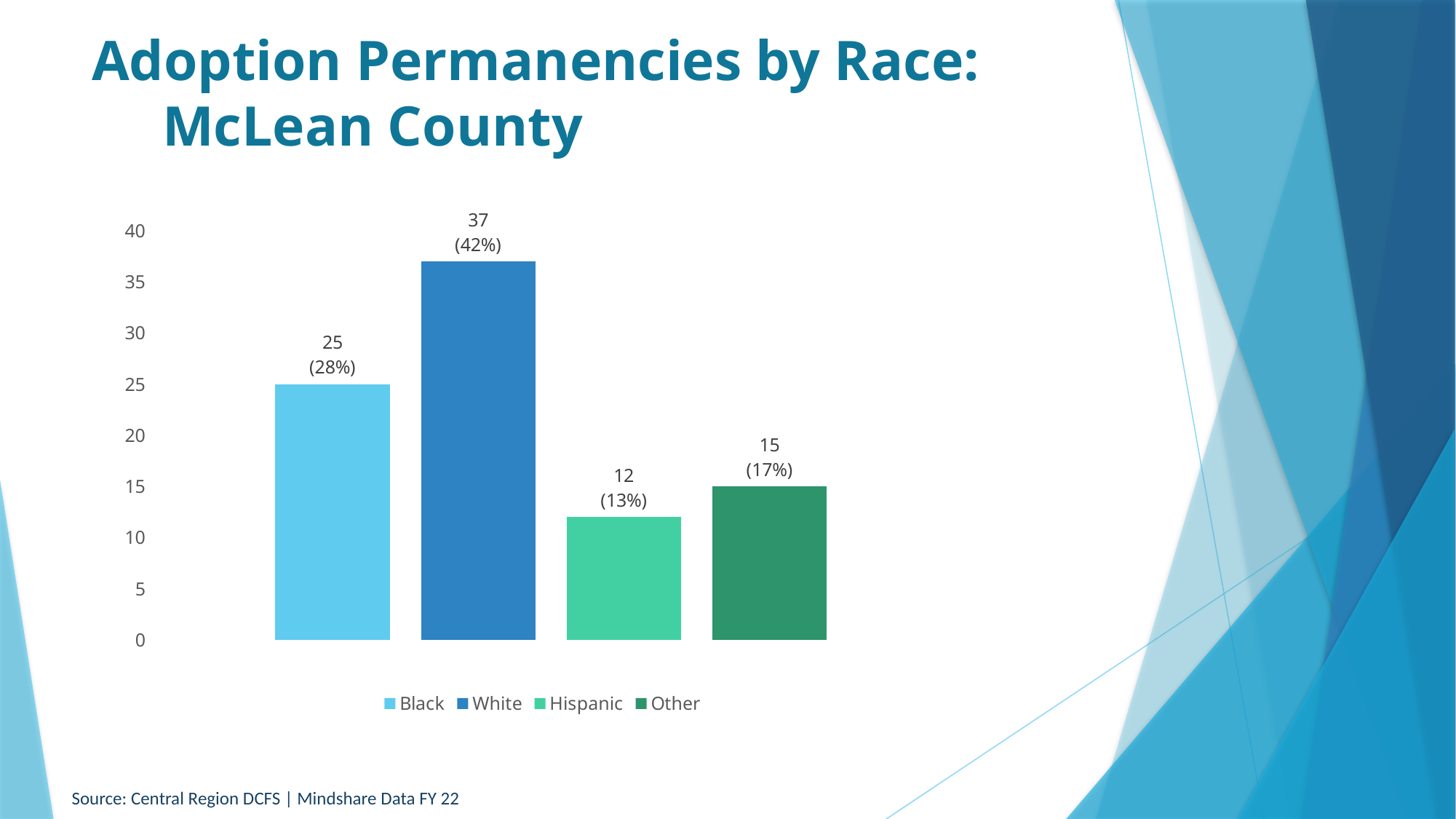
What is the difference between the White and Black values? 12 Which is larger, the value for Other or the value for Hispanic? Other What kind of chart is shown on the slide? Bar chart How many race categories are shown in the chart? 4 Which race category has the lowest number of adoption permanencies? Hispanic Which race category has the highest number of adoption permanencies? White What is the number of adoption permanencies for White in McLean County? 37 What is the number of adoption permanencies for Black in McLean County? 25 What percentage is shown for Hispanic? 13% Is the value for Black greater or less than 20? greater What is the value for Other? 15 What is the source cited at the bottom of the slide? Central Region DCFS | Mindshare Data FY 22